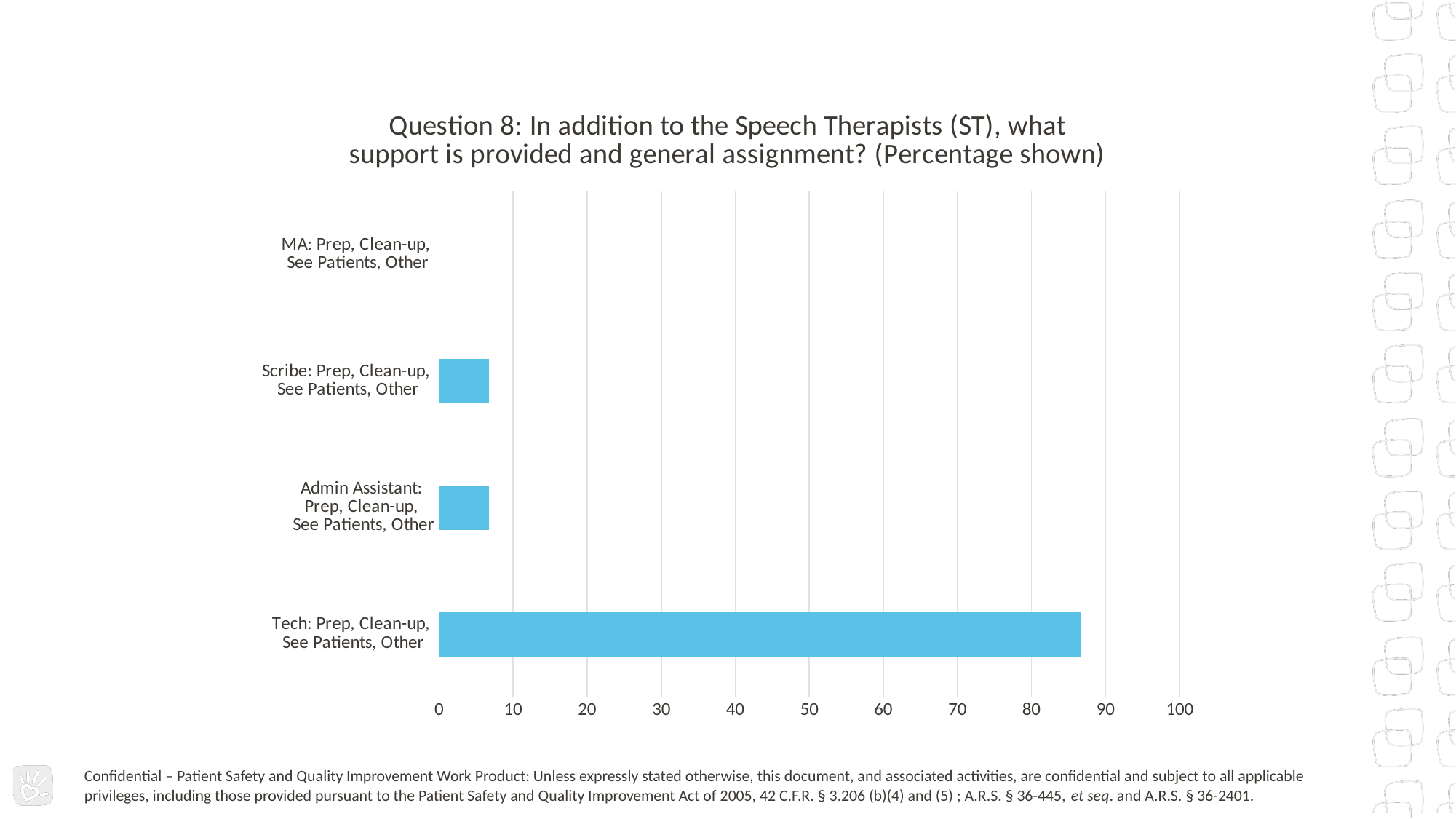
Is the value for Admin Assistant: Prep, Clean-up, See Patients, Other greater or less than 10? less Which category has the highest value? Tech: Prep, Clean-up, See Patients, Other What kind of chart is shown on the slide? bar chart Which is larger, the value for Tech: Prep, Clean-up, See Patients, Other or the value for Scribe: Prep, Clean-up, See Patients, Other? Tech: Prep, Clean-up, See Patients, Other What is the title of the chart? Question 8: In addition to the Speech Therapists (ST), what support is provided and general assignment? (Percentage shown) How many categories are shown on the chart? 4 Which category has the lowest value? MA: Prep, Clean-up, See Patients, Other Is the value for Tech: Prep, Clean-up, See Patients, Other greater or less than 90? less Is the value for MA: Prep, Clean-up, See Patients, Other greater or less than 10? less What is the maximum value shown on the horizontal axis? 100